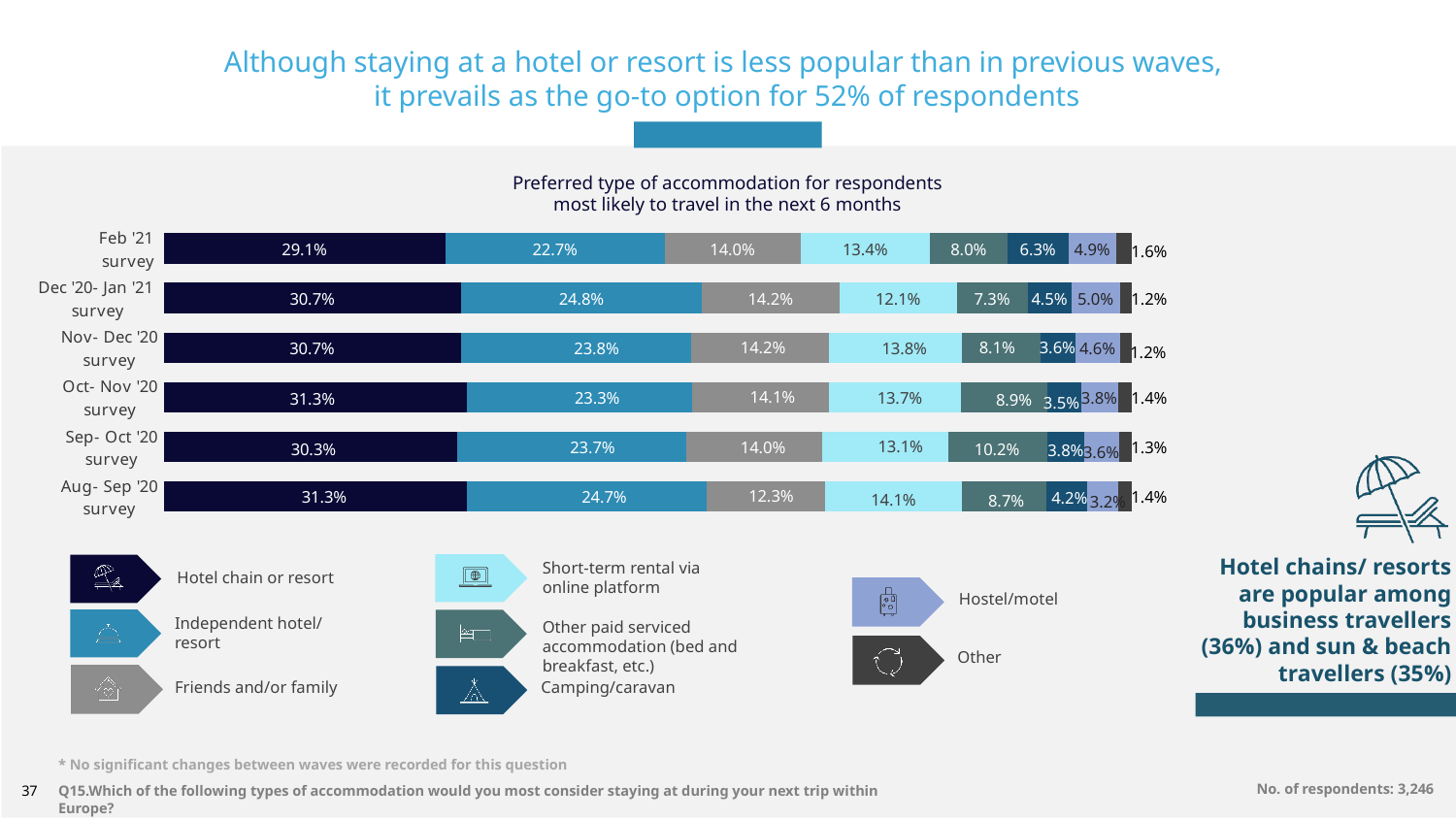
What type of chart is shown on the slide? Stacked bar chart What is the value for Independent hotel/resort in the Dec '20- Jan '21 survey? 24.8% Which is larger in the Nov- Dec '20 survey: Friends and/or family or Short-term rental via online platform? Friends and/or family Which survey wave has the highest value for Camping/caravan? Feb '21 survey What is the value for Other paid serviced accommodation in the Sep- Oct '20 survey? 10.2% Which survey wave has the lowest value for Hotel chain or resort? Feb '21 survey What is the title of the chart? Preferred type of accommodation for respondents most likely to travel in the next 6 months What share of respondents in the Feb '21 survey preferred a hotel chain or resort? 29.1% How many survey waves (categories) are shown in the chart? 6 What is the difference between the Hotel chain or resort values in the Oct- Nov '20 survey and the Feb '21 survey? 2.2 percentage points How many accommodation types does the legend list? 8 What is the value for Short-term rental via online platform in the Aug- Sep '20 survey? 14.1%